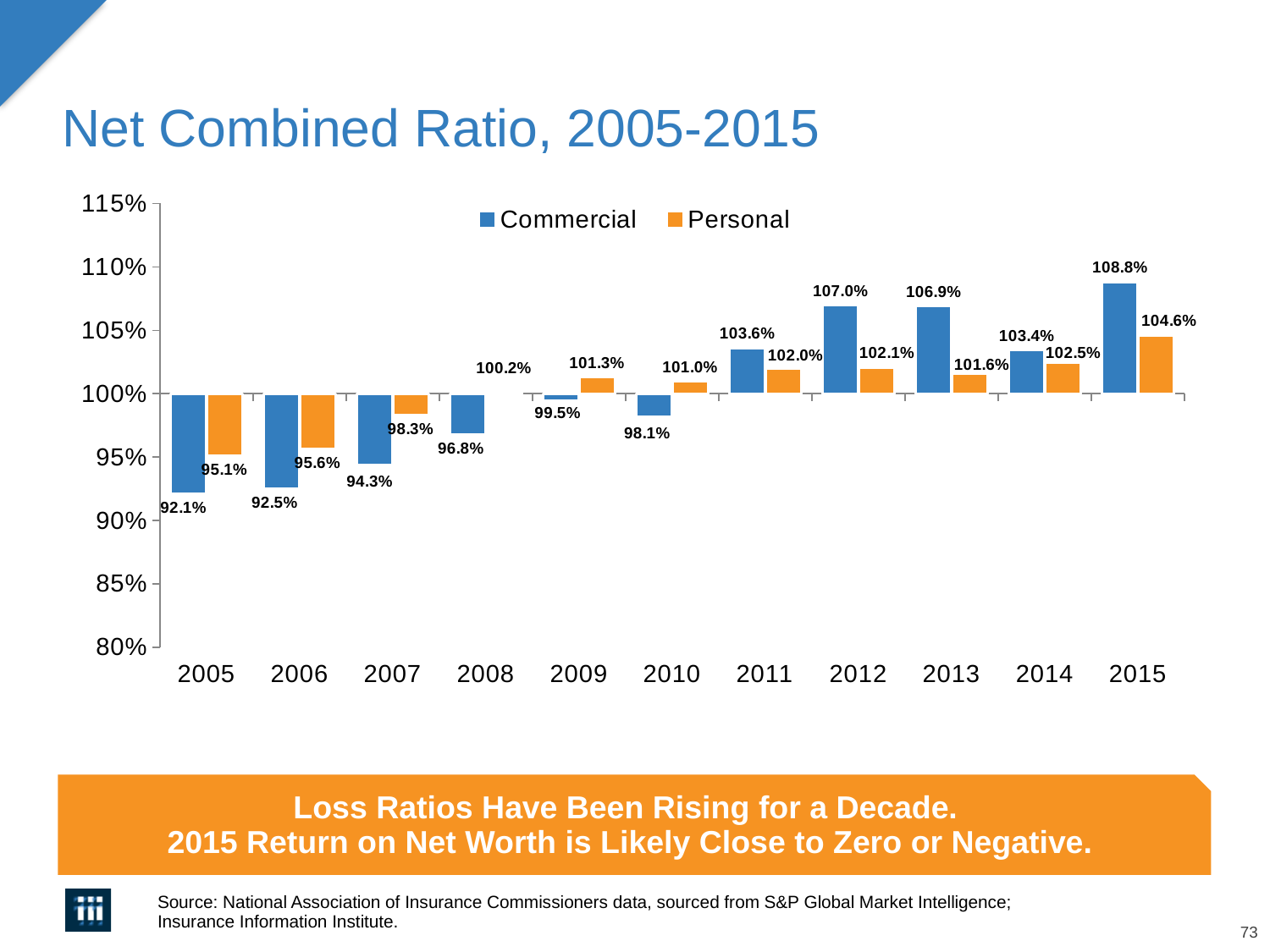
What is the Commercial net combined ratio for 2010? 98.1% What is the Personal net combined ratio for 2009? 101.3% How many series does the legend list? 2 In which year is the Personal net combined ratio lowest? 2005 Which series has the higher net combined ratio in 2007, Commercial or Personal? Personal What is the difference between the Commercial and Personal net combined ratios in 2012? 4.9% What is the Commercial net combined ratio for 2015? 108.8% How many years are shown on the x axis of the chart? 11 Is the Commercial net combined ratio for 2013 greater or less than 105%? greater What kind of chart is shown on the slide? Bar chart Does the Commercial net combined ratio generally rise or fall from 2005 to 2015? Rise In which year is the Commercial net combined ratio highest? 2015